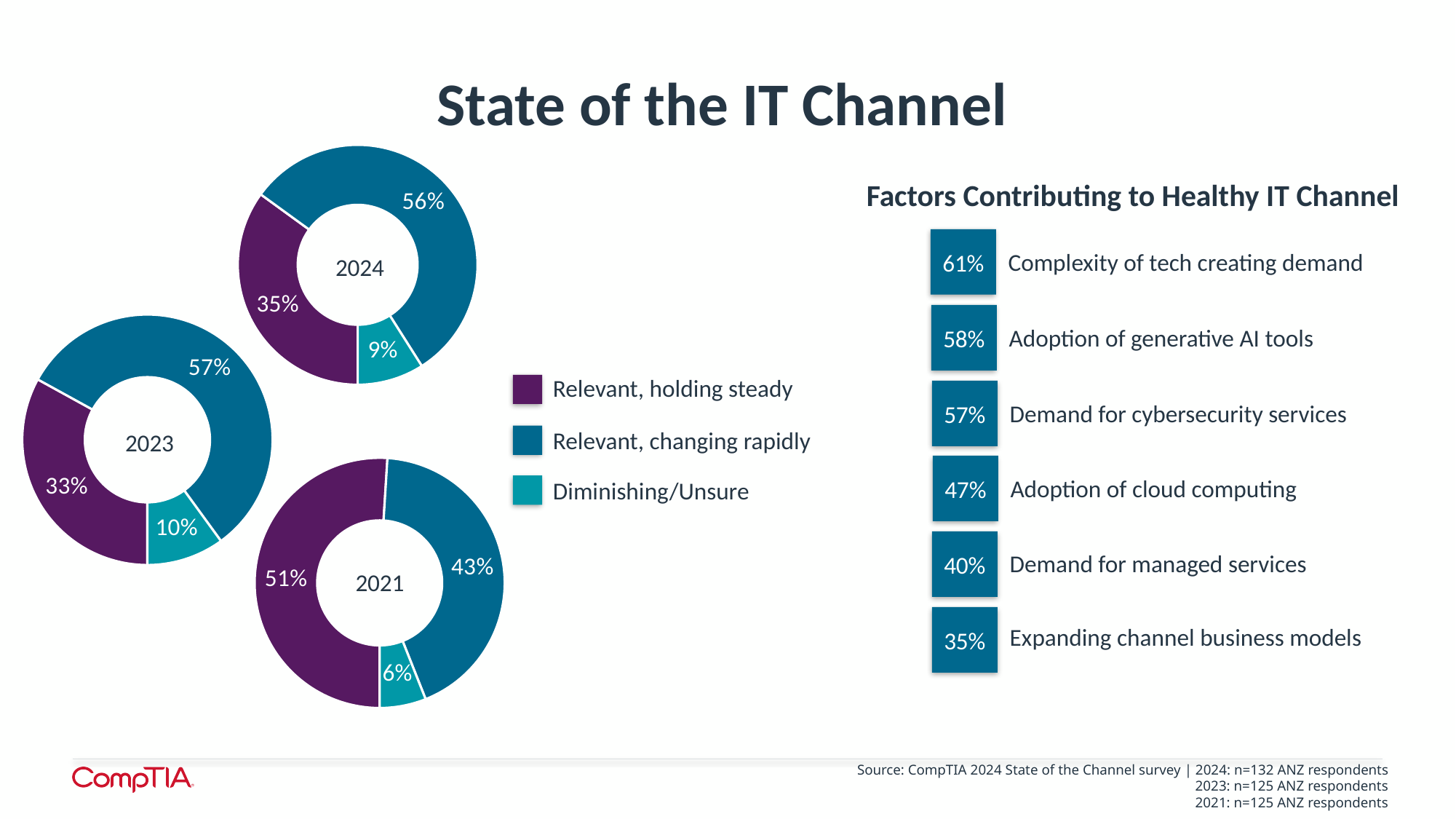
In the 2024 donut chart, which category has the smallest share? Diminishing/Unsure In the 2024 donut chart, what percentage is shown for 'Relevant, changing rapidly'? 56% In the 2021 donut chart, which category has the largest share? Relevant, holding steady In the 'Factors Contributing to Healthy IT Channel' list, what percentage is shown for 'Adoption of generative AI tools'? 58% In the 2023 donut chart, what percentage is shown for 'Relevant, holding steady'? 33% In the 2021 donut chart, what percentage is shown for 'Diminishing/Unsure'? 6% Is the 'Relevant, holding steady' share larger in the 2021 donut chart or the 2024 donut chart? 2021 In the 'Factors Contributing to Healthy IT Channel' list, which factor has the lowest percentage? Expanding channel business models What type of chart is used to show the 2024, 2023 and 2021 data on the left of the slide? Donut chart In the 2023 donut chart, what is the difference between 'Relevant, changing rapidly' and 'Relevant, holding steady'? 24 percentage points How many series does the legend for the donut charts list? 3